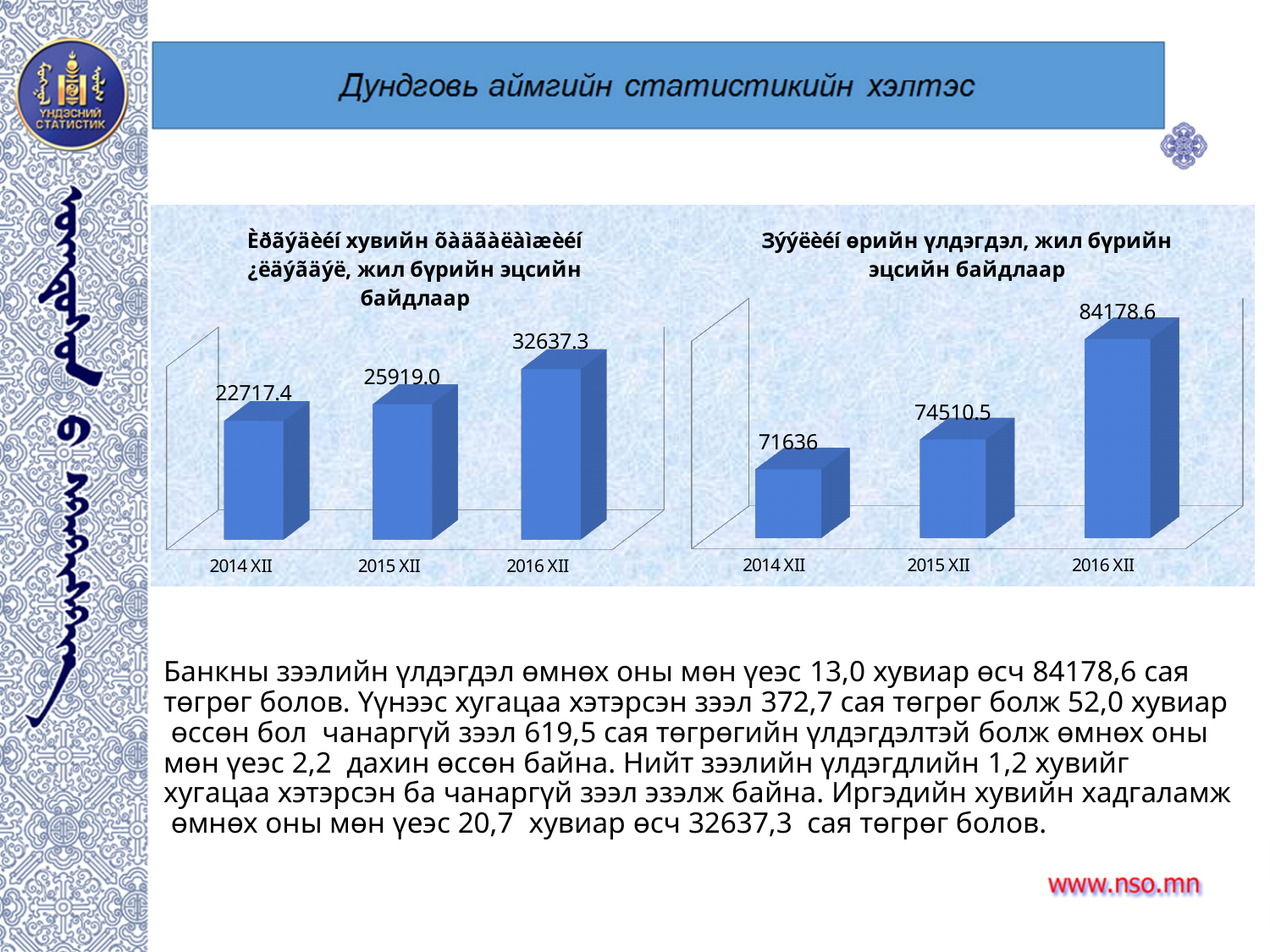
In the left chart, do the values rise or fall from 2014 XII to 2016 XII? Rise In the right chart, what is the value for 2014 XII? 71636 In the left chart, what is the value for 2016 XII? 32637.3 In the left chart, what is the value for 2014 XII? 22717.4 In the right chart, which period has the highest value? 2016 XII In the right chart, what is the difference between the 2016 XII and 2015 XII values? 9668.1 In the right chart, what is the value for 2015 XII? 74510.5 In the left chart, what is the difference between the 2016 XII and 2015 XII values? 6718.3 In the left chart, which period has the lowest value? 2014 XII How many bars are shown in the left chart? 3 In the right chart, which is larger, the value for 2014 XII or 2015 XII? 2015 XII What type of chart is the right chart? Bar chart